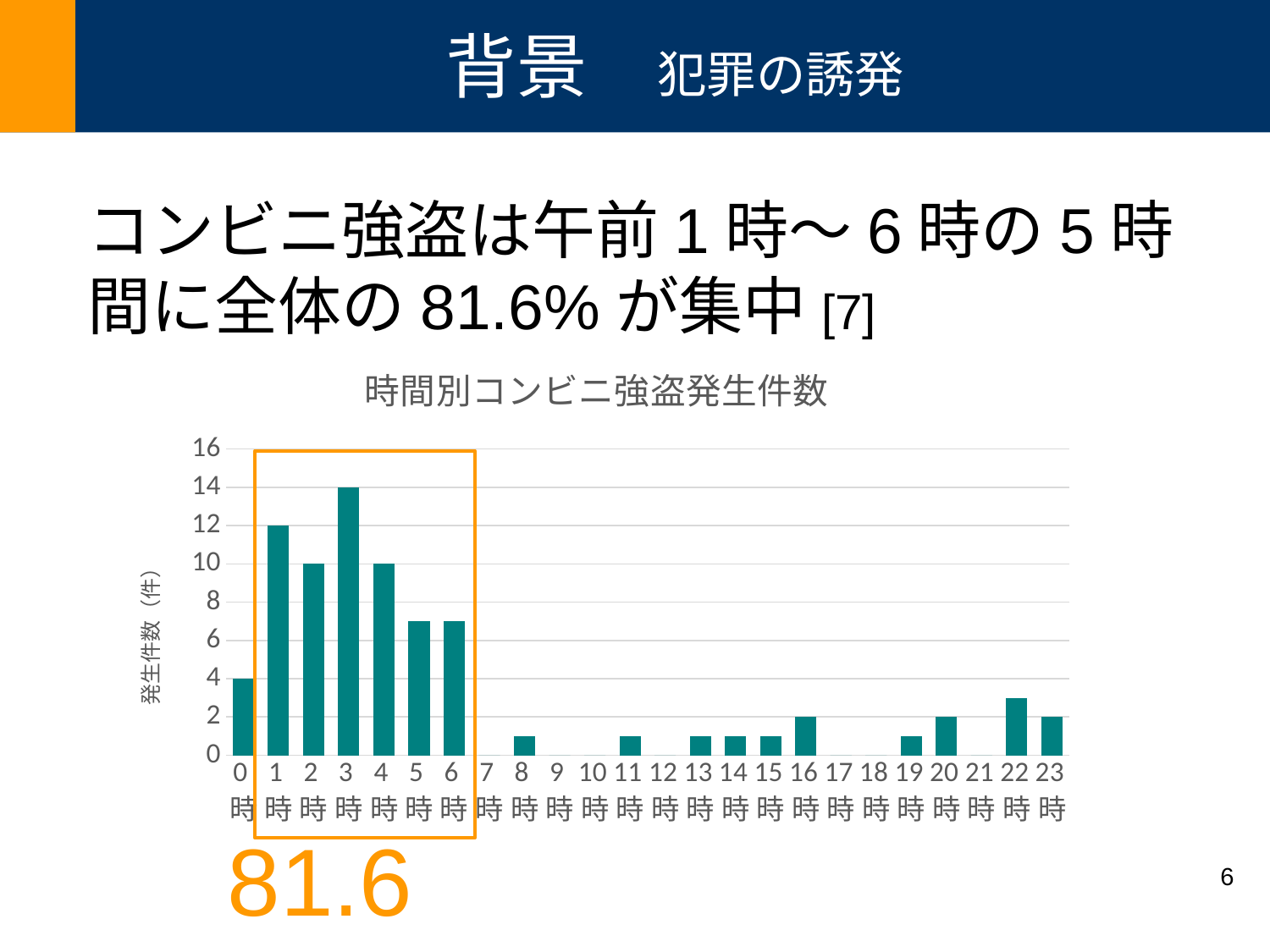
What is the value for 0時? 4 How many hour categories are shown on the x axis? 24 What is the value for 3時? 14 What is the difference between the values for 3時 and 1時? 2 What is the value for 1時? 12 Which hour has the highest number of incidents? 3時 Which is larger, the value for 1時 or the value for 2時? 1時 Is the value for 5時 greater or less than 8? less Do the values rise or fall from 3時 to 7時? fall What kind of chart is shown on the slide? bar chart What is the title of the chart? 時間別コンビニ強盗発生件数 What is the label of the vertical axis? 発生件数（件）